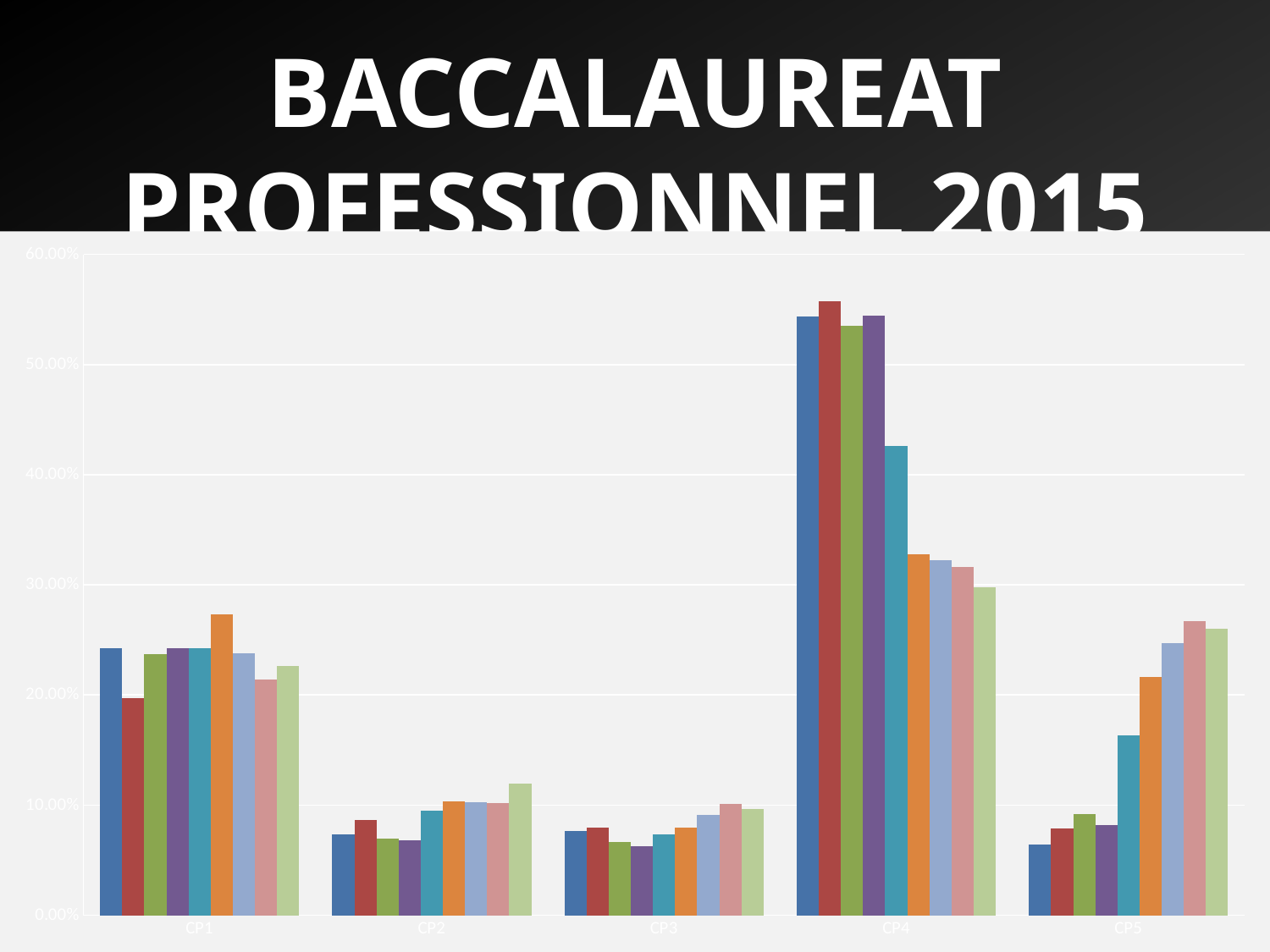
Is the value of the last (light green) bar for CP5 greater or less than 20%? greater What is the title of the slide containing the chart? BACCALAUREAT PROFESSIONNEL 2015 How many categories are shown on the x axis of the chart? 5 Which is larger, the last (light green) bar for CP5 or the last (light green) bar for CP2? CP5 Is the value of the first (blue) bar for CP1 greater or less than 30%? less Is the value of the first (blue) bar for CP5 greater or less than 10%? less How many bars are plotted for each category? 9 What kind of chart is shown on the slide? bar chart Which category has the tallest bars in the chart? CP4 Which is larger, the first (blue) bar for CP4 or the first (blue) bar for CP1? CP4